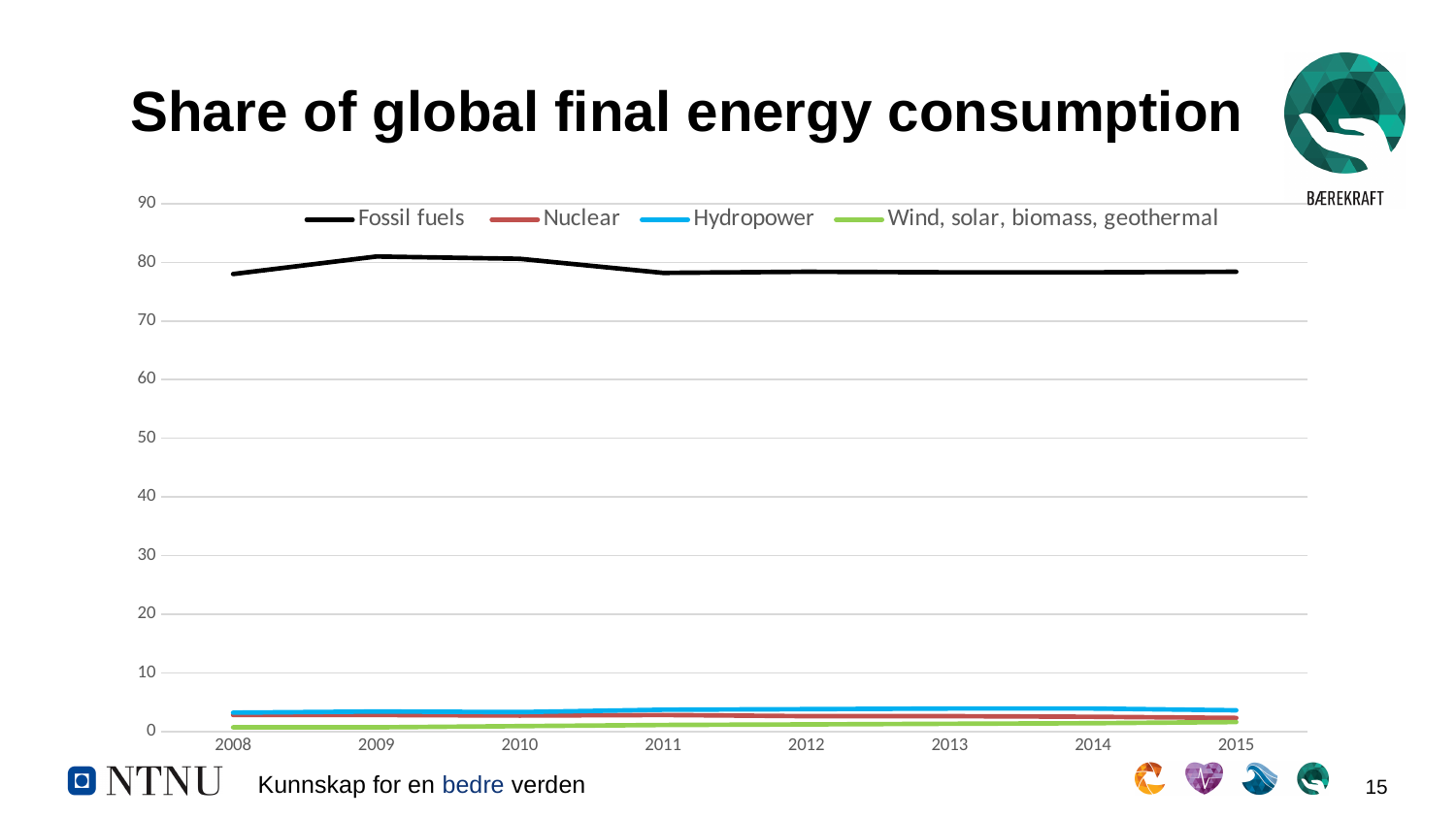
How many series does the legend list? 4 Does the Wind, solar, biomass, geothermal series rise or fall from 2008 to 2015? rise Is the value for Fossil fuels in 2015 greater or less than 80? less What is the title of the chart? Share of global final energy consumption What kind of chart is shown on the slide? line chart Is the value for Fossil fuels in 2009 greater or less than 70? greater How many years are shown on the x axis? 8 Which series has the lowest value in 2008? Wind, solar, biomass, geothermal Is the value for Hydropower in 2012 greater or less than 10? less Which is larger in 2010, Fossil fuels or Hydropower? Fossil fuels Does the Fossil fuels series rise or fall from 2009 to 2011? fall Which series has the highest value in 2013? Fossil fuels